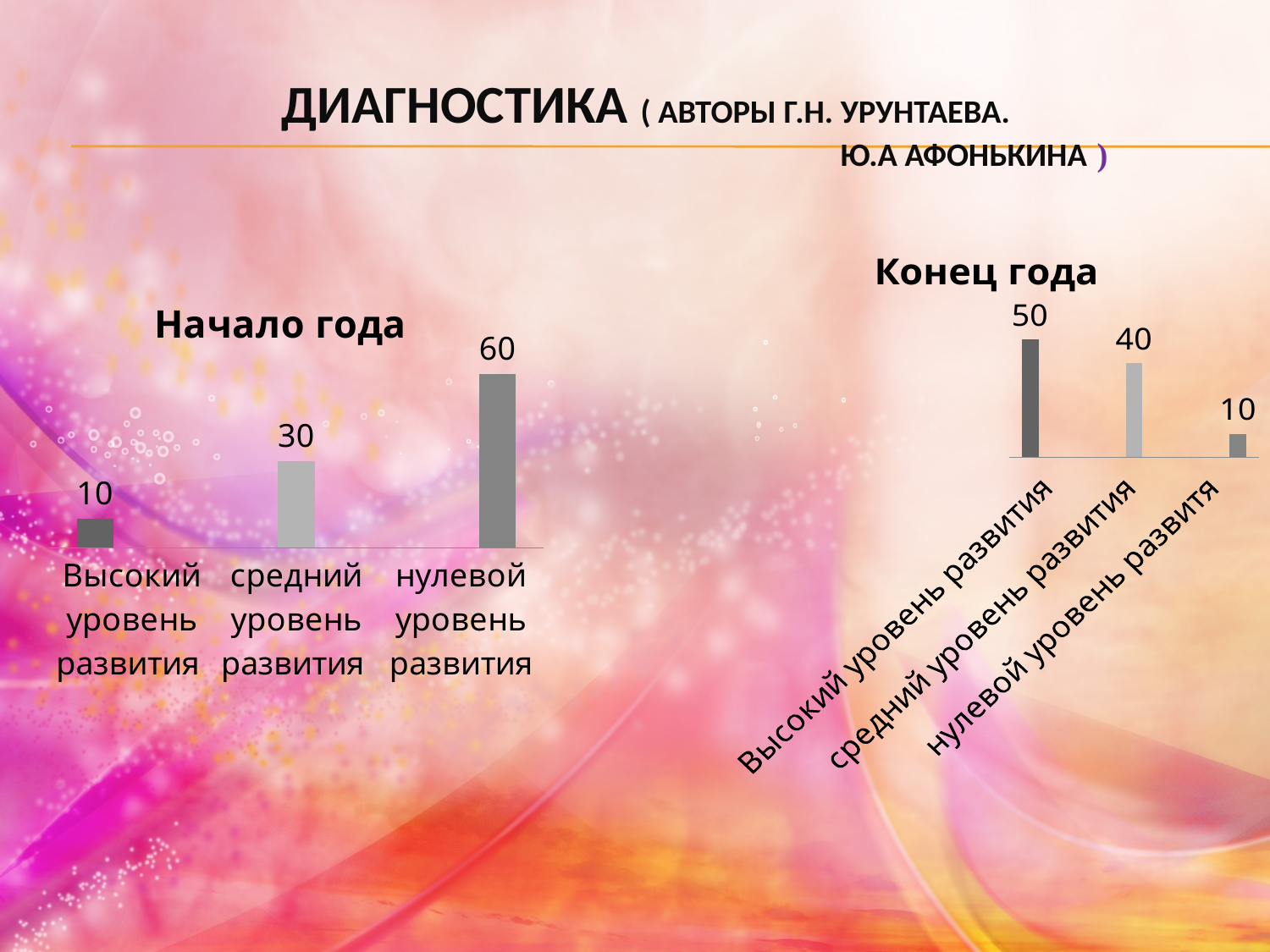
In the "Конец года" chart, what is the difference between "Высокий уровень развития" and "нулевой уровень развития"? 40 In the "Конец года" chart, what is the value for "средний уровень развития"? 40 In the "Конец года" chart, which category has the highest value? Высокий уровень развития What type of chart is the "Конец года" chart? Bar chart What is the title of the chart on the right side of the slide? Конец года In the "Начало года" chart, what is the value for "нулевой уровень развития"? 60 In the "Начало года" chart, what is the difference between "нулевой уровень развития" and "средний уровень развития"? 30 In the "Начало года" chart, which category has the lowest value? Высокий уровень развития How many categories does the "Начало года" chart show? 3 In the "Начало года" chart, what is the value for "Высокий уровень развития"? 10 In the "Начало года" chart, do the values rise or fall from left to right? Rise Which is larger: "Высокий уровень развития" in the "Начало года" chart or "Высокий уровень развития" in the "Конец года" chart? Конец года